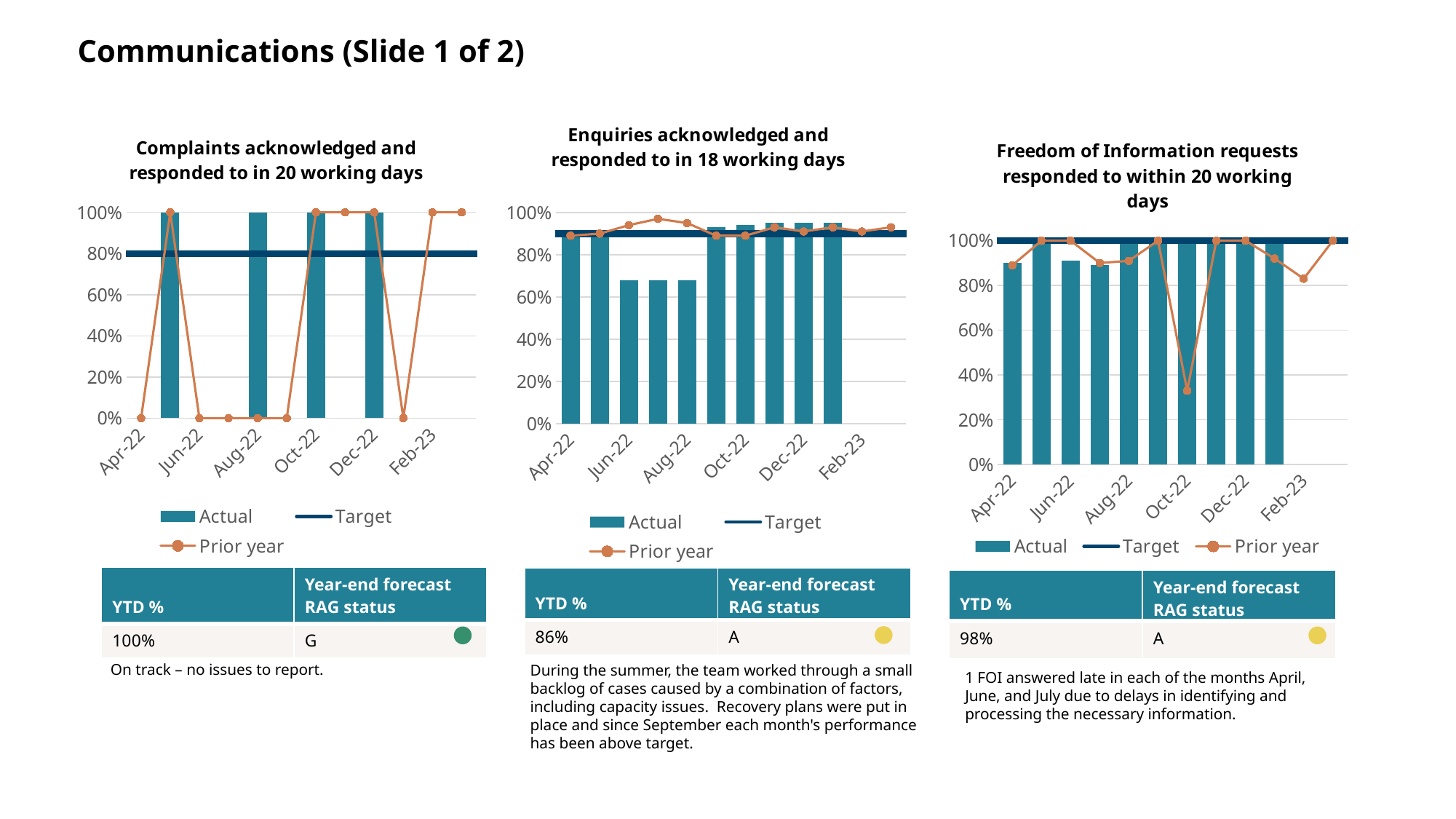
On the 'Complaints acknowledged and responded to in 20 working days' chart, how many Actual bars are plotted? 4 On the 'Enquiries acknowledged and responded to in 18 working days' chart, is the Actual value for Jun-22 greater or less than 80%? less How many series does the legend list on the 'Enquiries acknowledged and responded to in 18 working days' chart? 3 On the 'Complaints acknowledged and responded to in 20 working days' chart, at what level is the Target line? 80% Which series is drawn as an orange line with circular markers on all three charts? Prior year On the 'Freedom of Information requests responded to within 20 working days' chart, is the Prior year value for Oct-22 greater or less than 40%? less On the 'Complaints acknowledged and responded to in 20 working days' chart, what is the Actual value for Aug-22? 100% On the 'Enquiries acknowledged and responded to in 18 working days' chart, is the Actual value for Jun-22 larger or smaller than the Actual value for Dec-22? smaller On the 'Enquiries acknowledged and responded to in 18 working days' chart, is the Actual value for Oct-22 greater or less than 80%? greater On the 'Freedom of Information requests responded to within 20 working days' chart, which month has the lowest Prior year value? Oct-22 On the 'Freedom of Information requests responded to within 20 working days' chart, at what level is the Target line? 100% What kind of chart is the 'Complaints acknowledged and responded to in 20 working days' chart? Bar chart with line series